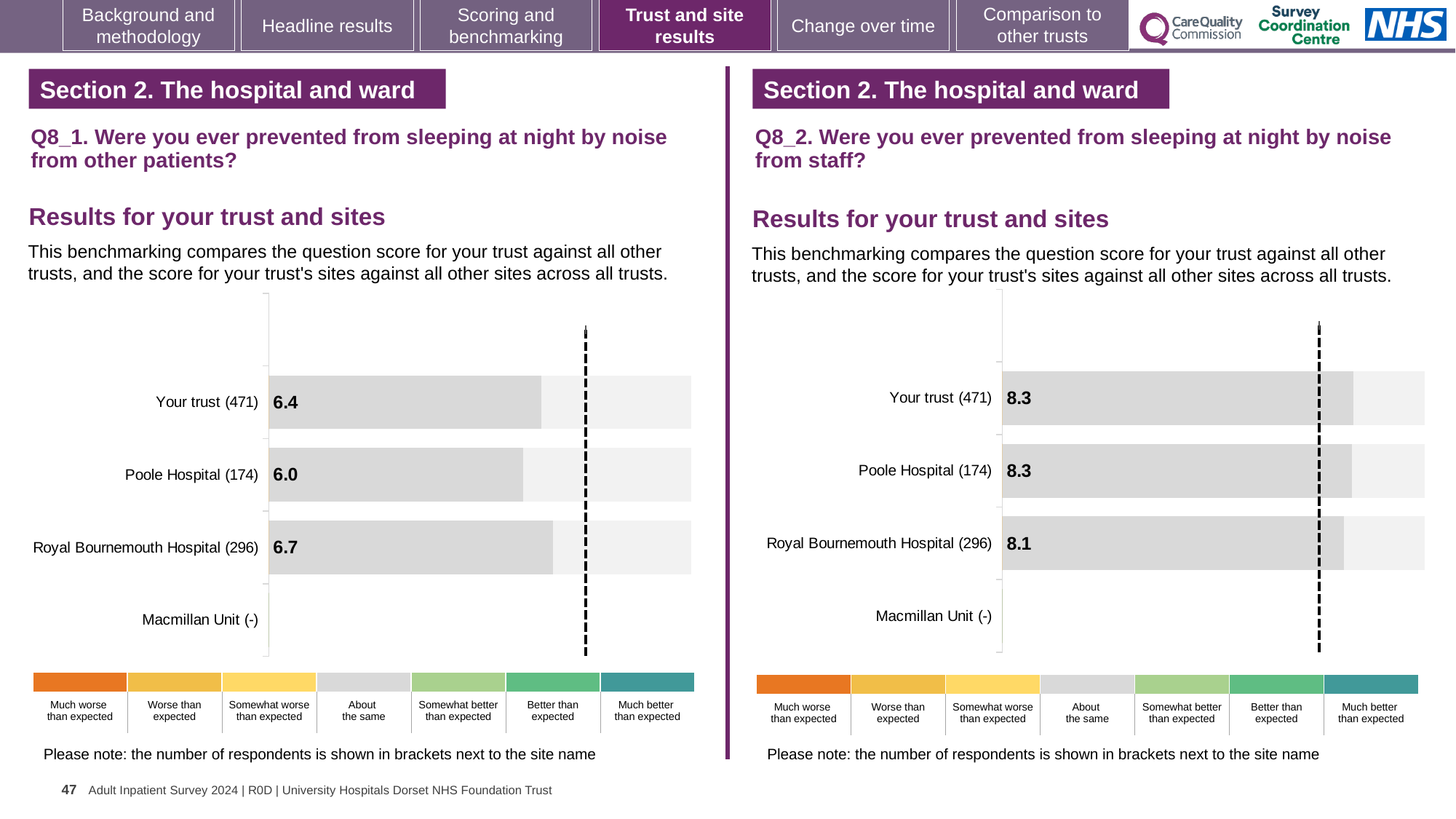
On the Q8_1 chart (noise from other patients), what is the score for Poole Hospital (174)? 6.0 On the Q8_1 chart (noise from other patients), which site has the highest score? Royal Bournemouth Hospital (296) On the Q8_1 chart (noise from other patients), what is the difference between the scores for Royal Bournemouth Hospital and Poole Hospital? 0.7 What kind of chart is used on the Q8_1 chart (noise from other patients)? Bar chart On the Q8_2 chart (noise from staff), what is the difference between the scores for Your trust and Royal Bournemouth Hospital? 0.2 On the Q8_2 chart (noise from staff), what is the score for Royal Bournemouth Hospital (296)? 8.1 On the Q8_1 chart (noise from other patients), what is the score for Royal Bournemouth Hospital (296)? 6.7 On the Q8_1 chart (noise from other patients), which site has the lowest score? Poole Hospital (174) On the Q8_2 chart (noise from staff), what is the score for Your trust (471)? 8.3 On the Q8_2 chart (noise from staff), which is larger, the score for Poole Hospital or the score for Royal Bournemouth Hospital? Poole Hospital How many site rows are listed on the Q8_2 chart (noise from staff), including Macmillan Unit? 4 On the Q8_1 chart (noise from other patients), what is the score for Your trust (471)? 6.4